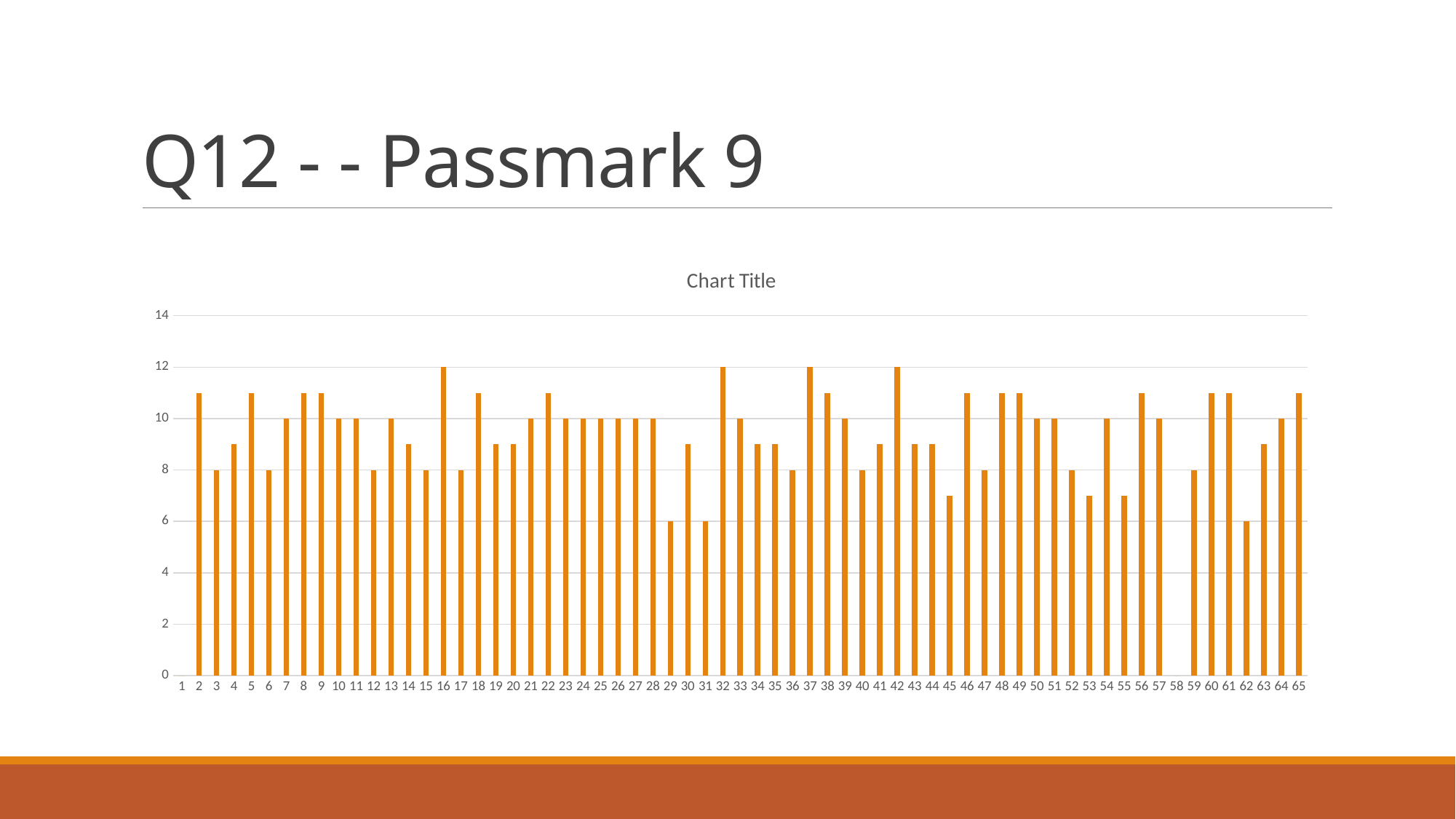
What is the title shown above the chart? Chart Title Which is larger, the value for category 16 or the value for category 29? category 16 What is the value for category 7? 10 How many categories are labelled on the x axis? 65 What is the difference between the values for category 16 and category 29? 6 What is the highest value reached by any bar in the chart? 12 Is the value for category 2 greater or less than 10? greater What is the value for category 16? 12 Is the value for category 45 greater or less than 8? less What is the value for category 3? 8 What is the value for category 29? 6 What kind of chart is shown on the slide? bar chart